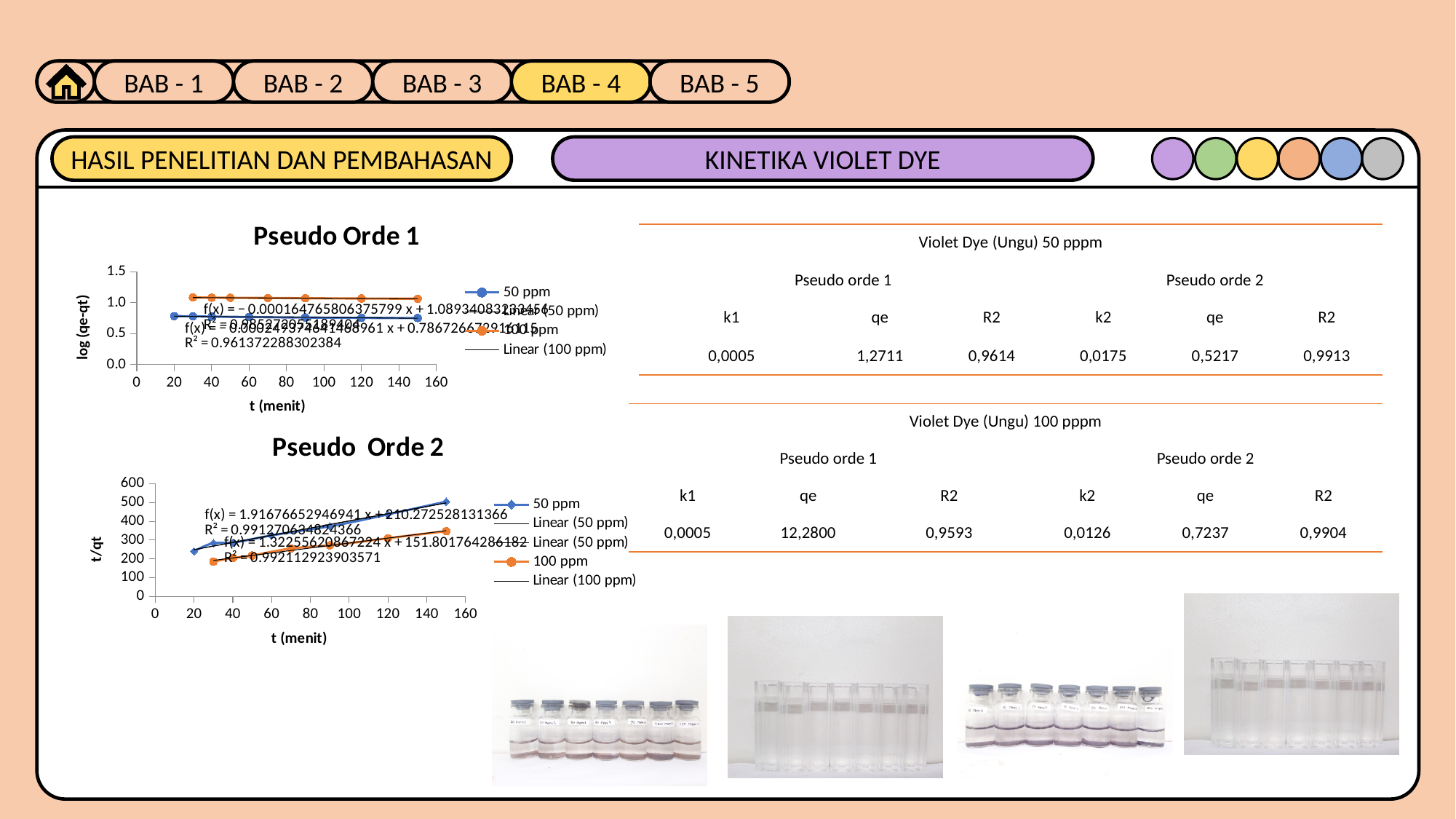
How many series does the legend of the 'Pseudo Orde 1' chart list? 4 How many entries does the legend of the 'Pseudo Orde 2' chart list? 5 In the 'Pseudo Orde 1' chart, which series has the higher values, 50 ppm or 100 ppm? 100 ppm In the 'Pseudo Orde 2' chart, do the values of the 50 ppm series rise or fall as t increases? rise In the 'Pseudo Orde 1' chart, are the values for the 100 ppm series greater or less than 1.0? greater In the 'Pseudo Orde 2' chart, is the value of the 50 ppm series at t = 150 greater or less than 400? greater In the 'Pseudo Orde 2' chart, which series has the higher value at t = 150, 50 ppm or 100 ppm? 50 ppm In the 'Pseudo Orde 1' chart, are the values for the 50 ppm series greater or less than 1.0? less What is the x-axis title of the 'Pseudo Orde 2' chart? t (menit) What is the y-axis title of the 'Pseudo Orde 1' chart? log (qe-qt) What type of chart is the 'Pseudo Orde 1' chart? line chart